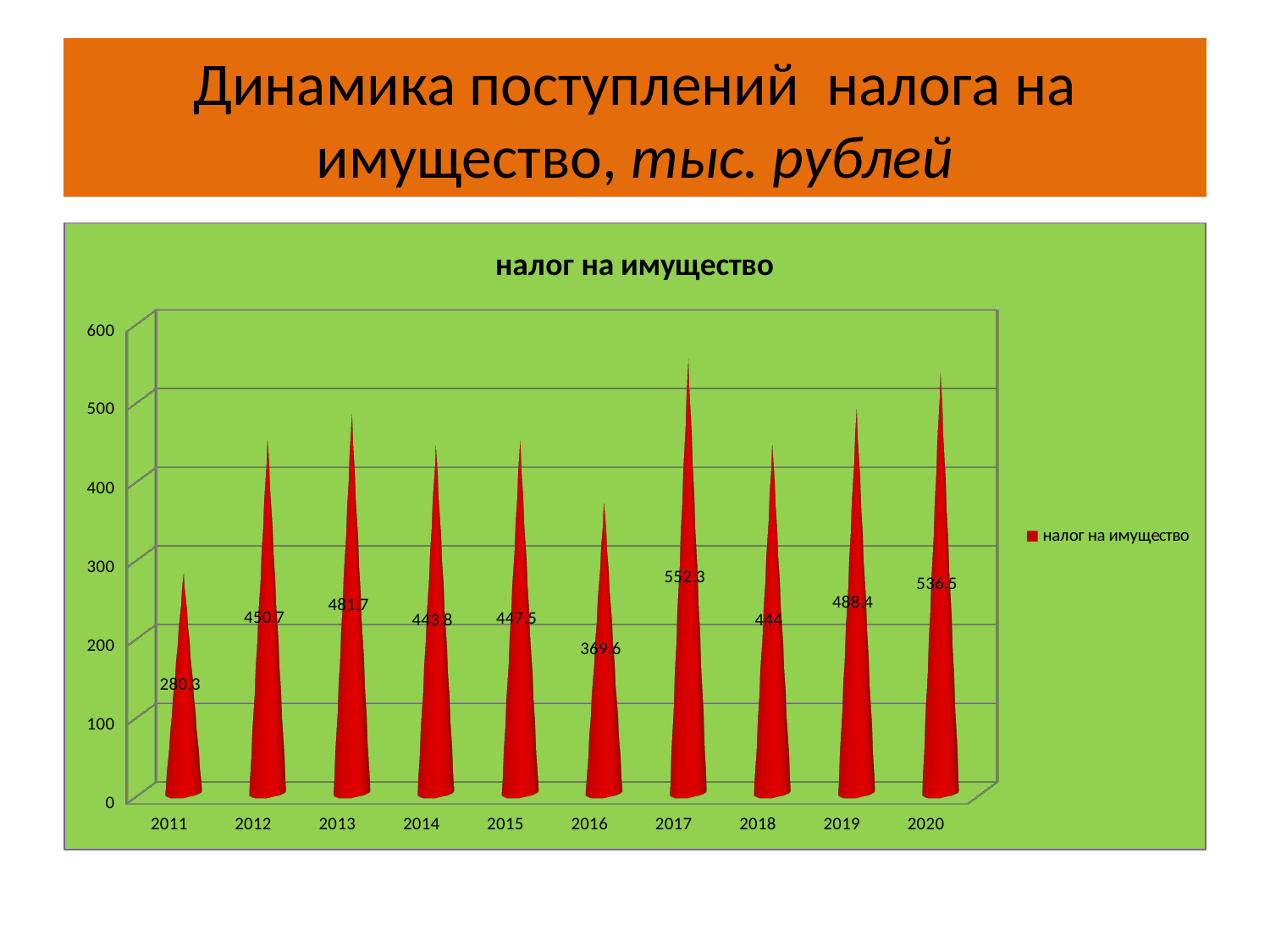
Is the value for 2016 greater or less than 400? less How many years are shown on the x axis of the chart? 10 How many series does the legend list? 1 What is the difference between the values for 2017 and 2016? 182.7 Which is larger, the value for 2019 or the value for 2013? 2019 What is the value for 2018 in the chart? 444 What is the difference between the values for 2020 and 2011? 256.2 What is the value for 2017 in the chart? 552.3 What kind of chart is shown on the slide? bar chart What is the value for 2011 in the chart? 280.3 Which year has the highest value in the chart? 2017 Which year has the lowest value in the chart? 2011